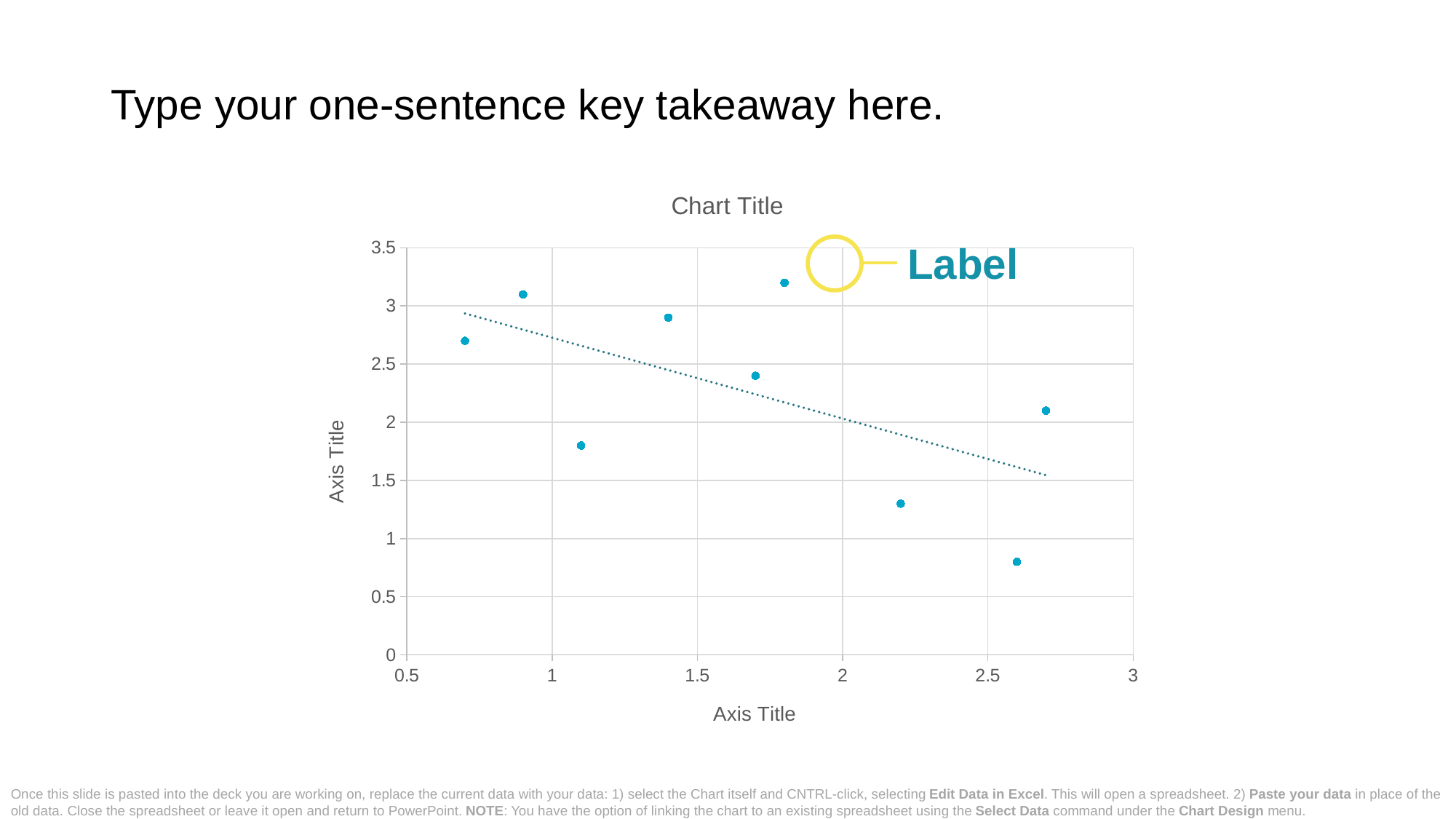
Is the y value of the point at x = 2.6 greater or less than 1? less Is the y value of the point at x = 0.7 greater or less than 2.5? greater Is the y value of the point at x = 1.1 greater or less than 2? less Which point has the lowest y value: the one at x = 2.6 or the one at x = 2.2? The point at x = 2.6 What is the title of the chart? Chart Title Which point has the higher y value: the one at x = 0.9 or the one at x = 1.1? The point at x = 0.9 What kind of chart is shown on the slide? Scatter chart What is the highest value shown on the y-axis? 3.5 Does the dotted trend line rise or fall as the x-axis value increases? Fall How many data points are plotted on the chart? 9